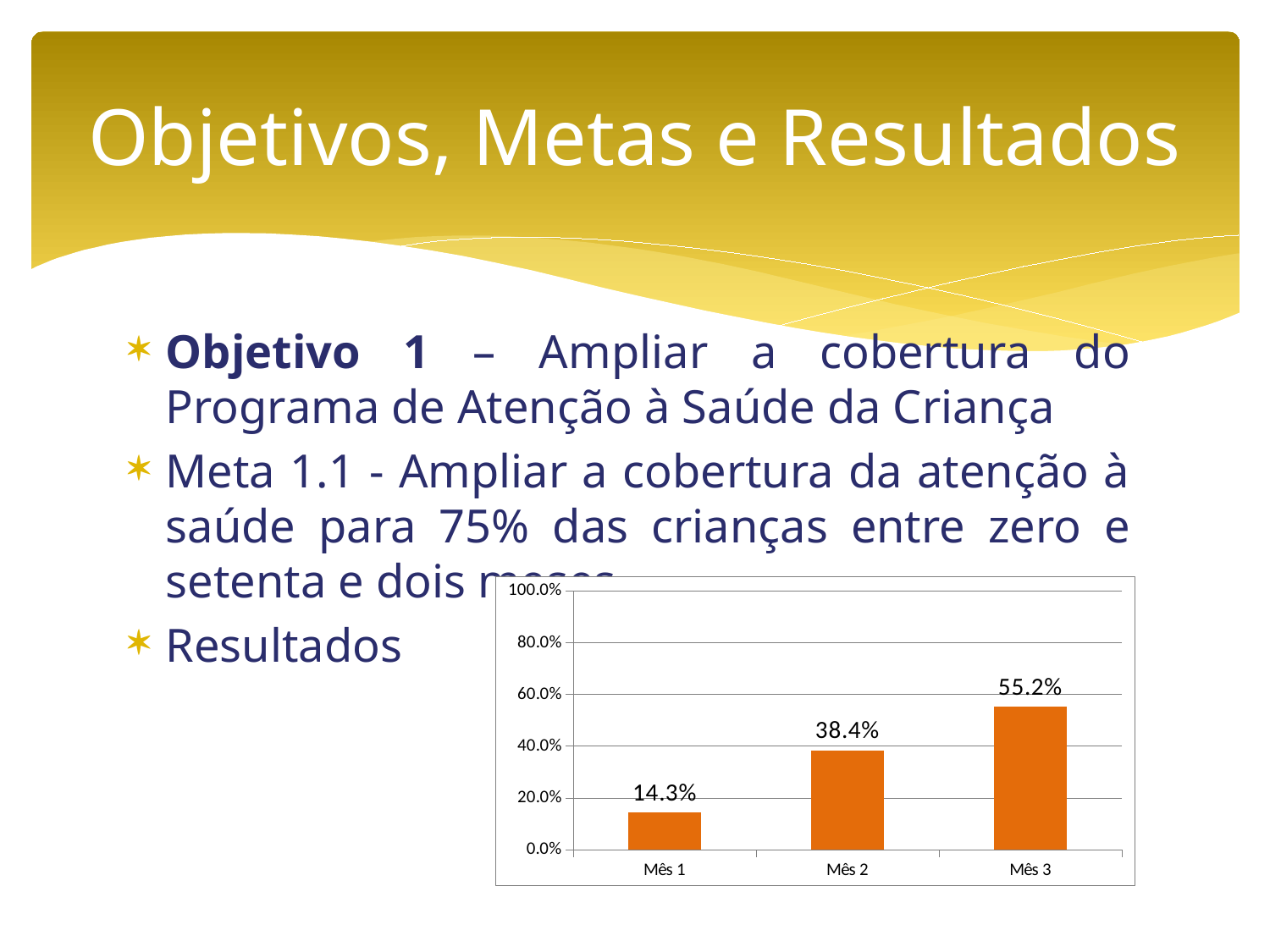
What is the value for Mês 3? 55.2% What is the difference between the values for Mês 2 and Mês 1? 24.1% Do the values rise or fall from Mês 1 to Mês 3? rise What is the value for Mês 1? 14.3% Is the value for Mês 3 greater or less than 60.0%? less Which category has the highest value? Mês 3 What is the difference between the values for Mês 3 and Mês 1? 40.9% How many categories are shown on the x axis? 3 What is the value for Mês 2? 38.4% Which category has the lowest value? Mês 1 Which is larger, the value for Mês 2 or the value for Mês 3? Mês 3 What kind of chart is shown on the slide? bar chart